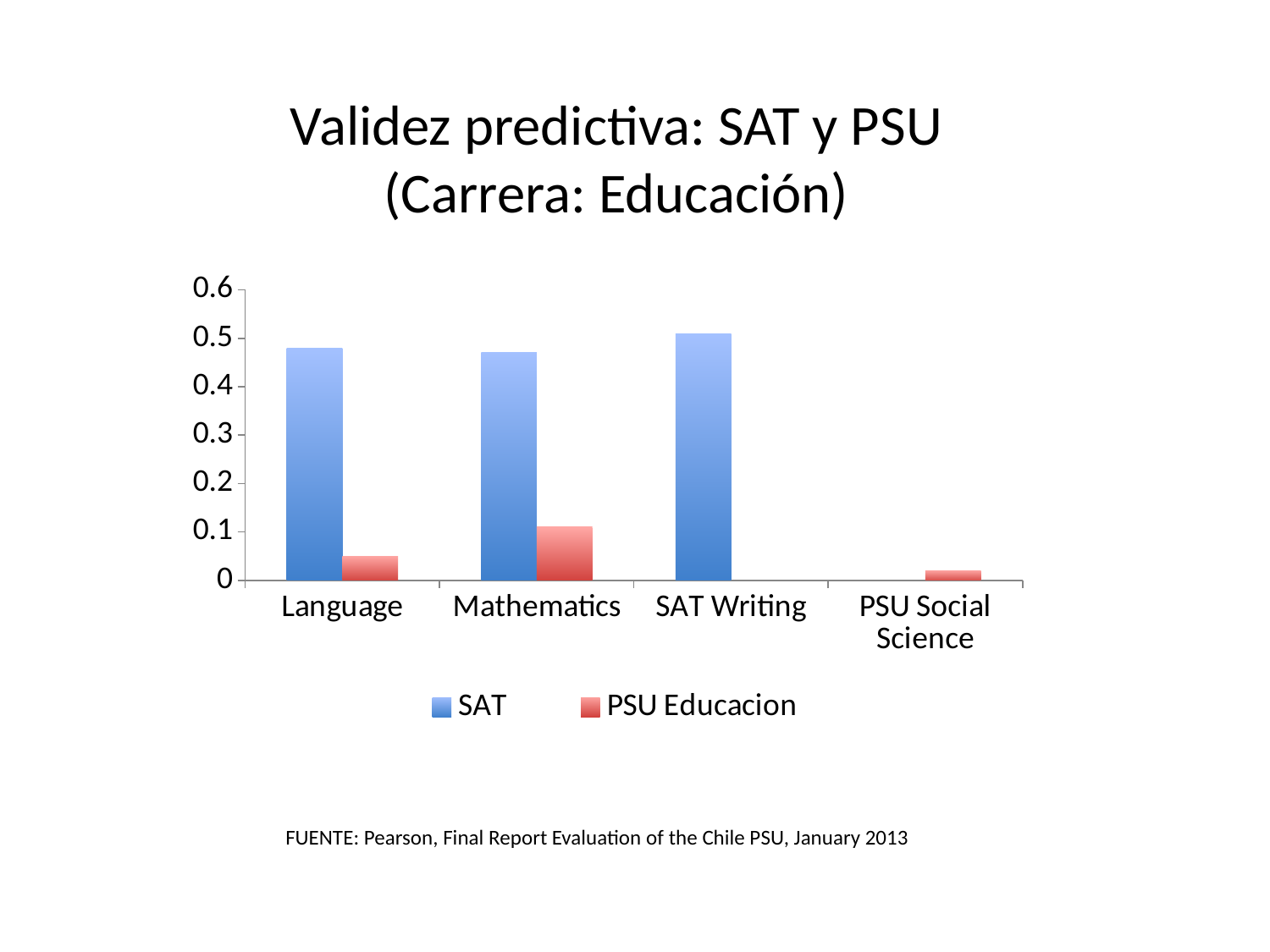
Is the PSU Educacion value for Language greater or less than 0.1? less What kind of chart is shown on the slide? Bar chart What colour are the PSU Educacion bars? Red Which category has the lowest PSU Educacion value? PSU Social Science For Mathematics, which is larger: the SAT value or the PSU Educacion value? SAT How many categories are shown on the x axis? 4 How many series does the legend list? 2 Which category has the highest PSU Educacion value? Mathematics Which category has the highest SAT value? SAT Writing